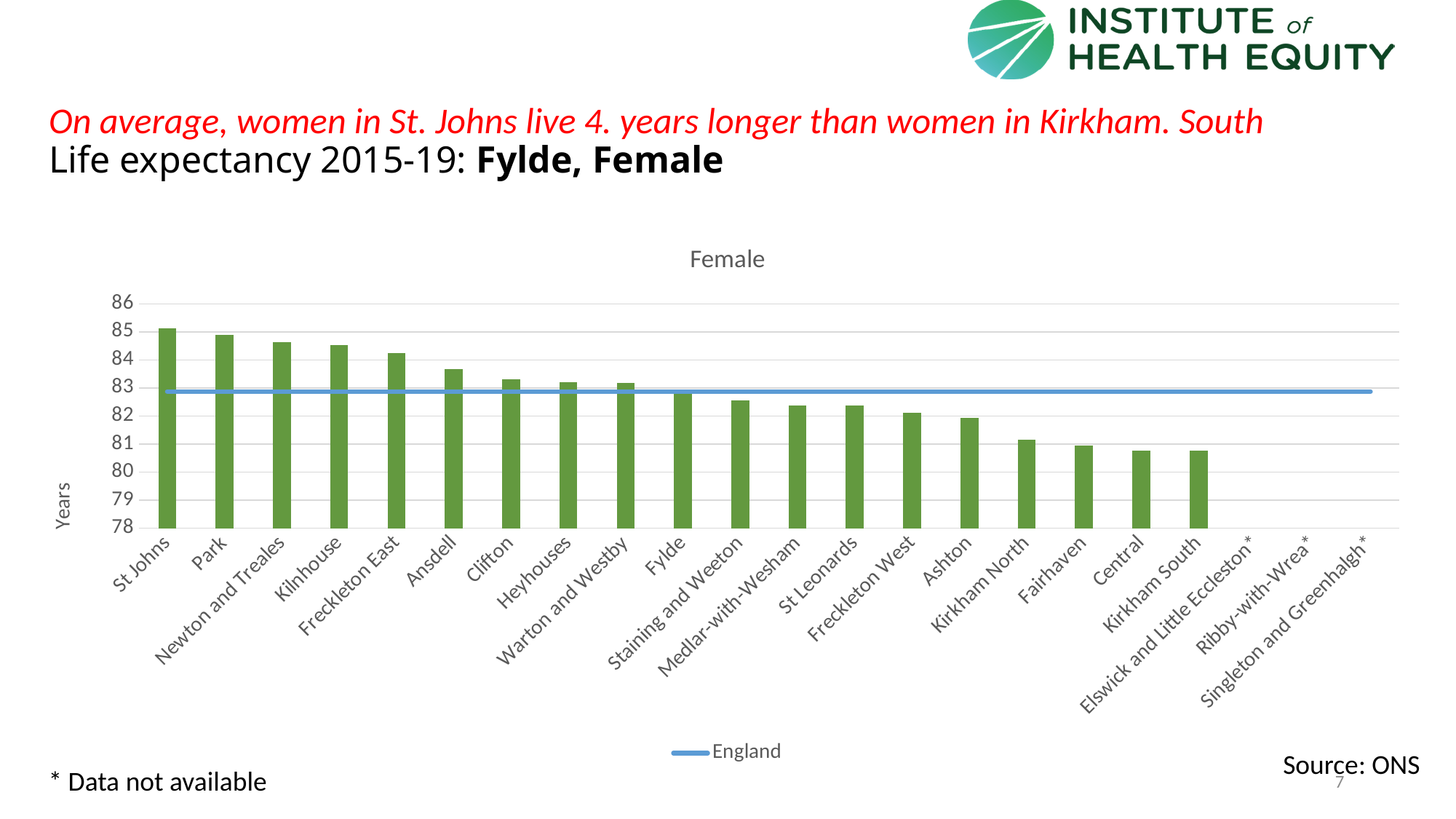
Is the value for Kirkham North greater or less than 82? less Is the value for Kirkham South greater or less than 81? less Which area has the highest female life expectancy in the chart? St Johns What is the label on the vertical axis of the chart? Years Is the value for Ansdell greater or less than 83? greater Do the bar values rise or fall from left to right along the x axis? fall How many areas are marked with an asterisk as having no data available? 3 How many entries does the chart legend list? 1 What kind of chart is shown on the slide? bar chart Which is larger, the value for Park or the value for Ashton? Park